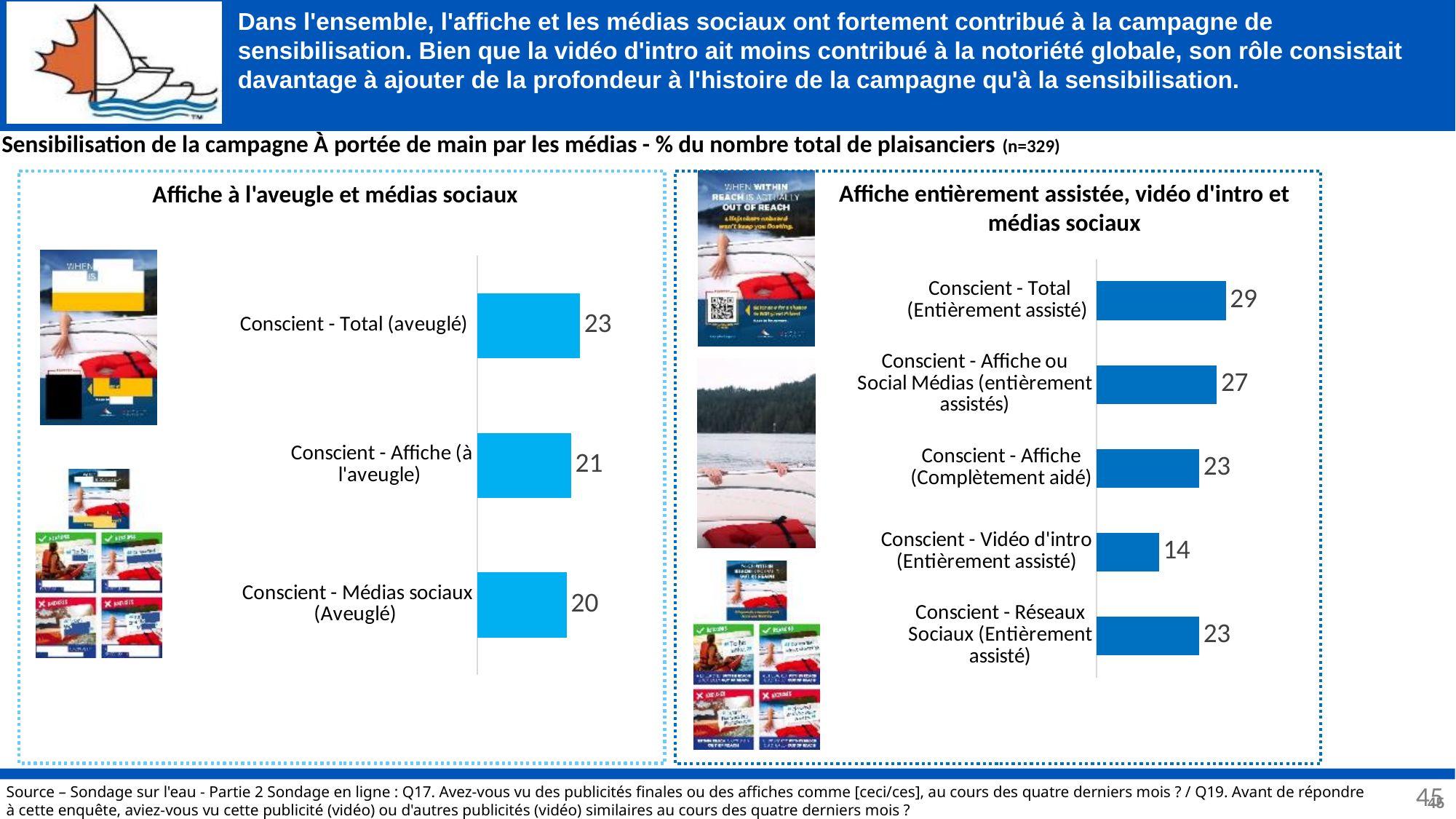
In the right chart 'Affiche entièrement assistée, vidéo d'intro et médias sociaux', which category has the highest value? Conscient - Total (Entièrement assisté) In the right chart 'Affiche entièrement assistée, vidéo d'intro et médias sociaux', what is the difference between 'Conscient - Total (Entièrement assisté)' and 'Conscient - Vidéo d'intro (Entièrement assisté)'? 15 In the right chart 'Affiche entièrement assistée, vidéo d'intro et médias sociaux', which category has the lowest value? Conscient - Vidéo d'intro (Entièrement assisté) In the left chart 'Affiche à l'aveugle et médias sociaux', which category has the highest value? Conscient - Total (aveuglé) What type of chart is the left chart 'Affiche à l'aveugle et médias sociaux'? Bar chart In the right chart 'Affiche entièrement assistée, vidéo d'intro et médias sociaux', which is larger: 'Conscient - Affiche (Complètement aidé)' or 'Conscient - Vidéo d'intro (Entièrement assisté)'? Conscient - Affiche (Complètement aidé) In the right chart 'Affiche entièrement assistée, vidéo d'intro et médias sociaux', what is the value for 'Conscient - Affiche ou Social Médias (entièrement assistés)'? 27 In the left chart 'Affiche à l'aveugle et médias sociaux', what is the difference between 'Conscient - Total (aveuglé)' and 'Conscient - Médias sociaux (Aveuglé)'? 3 In the left chart 'Affiche à l'aveugle et médias sociaux', what is the value for 'Conscient - Médias sociaux (Aveuglé)'? 20 How many categories are shown in the right chart 'Affiche entièrement assistée, vidéo d'intro et médias sociaux'? 5 In the left chart 'Affiche à l'aveugle et médias sociaux', what is the value for 'Conscient - Total (aveuglé)'? 23 In the right chart 'Affiche entièrement assistée, vidéo d'intro et médias sociaux', what is the value for 'Conscient - Vidéo d'intro (Entièrement assisté)'? 14